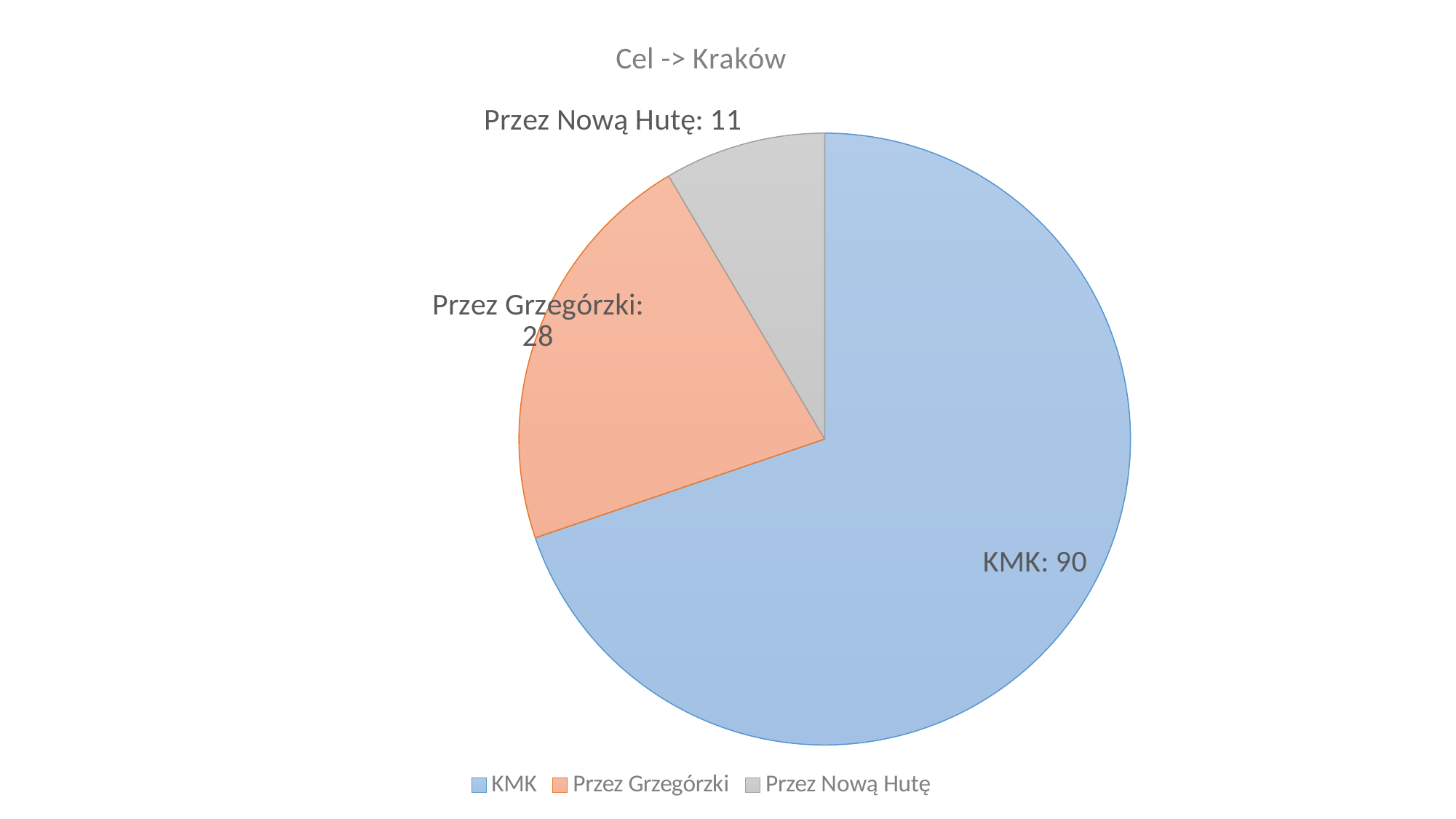
Which category has the largest slice? KMK Which category has the smallest slice? Przez Nową Hutę What kind of chart is shown? pie chart What is the value for Przez Nową Hutę? 11 What is the difference between the values for KMK and Przez Grzegórzki? 62 What is the title of the chart? Cel -> Kraków Which is larger, Przez Grzegórzki or Przez Nową Hutę? Przez Grzegórzki What is the difference between the values for Przez Grzegórzki and Przez Nową Hutę? 17 What is the total of all slices in the pie? 129 What is the value for Przez Grzegórzki? 28 What is the value for KMK? 90 How many slices does the pie chart have? 3